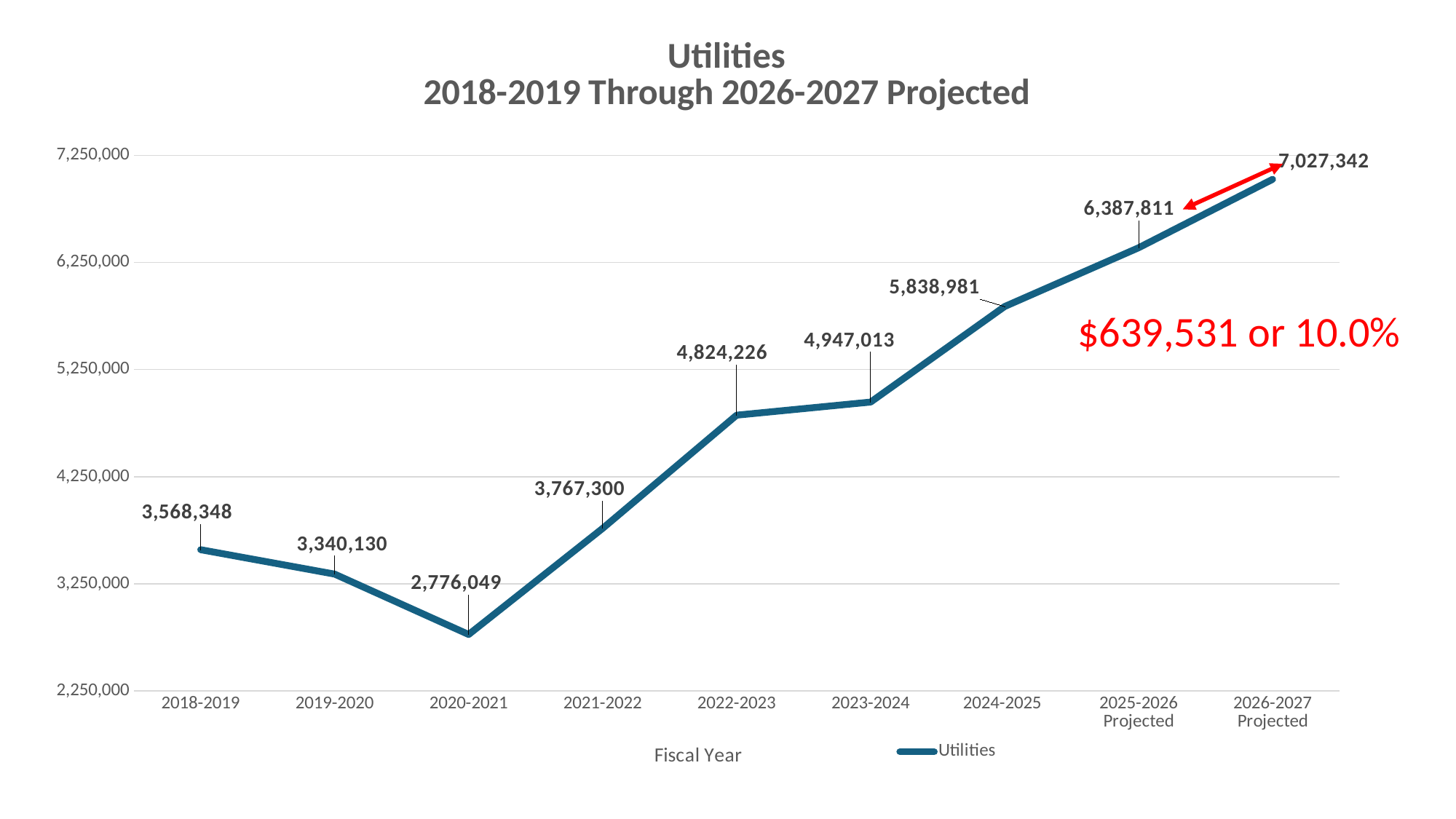
What is the projected Utilities value for 2026-2027? 7,027,342 What is the Utilities value for 2023-2024? 4,947,013 What is the difference between the 2018-2019 and 2019-2020 Utilities values? 228,218 Which fiscal year has the lowest Utilities value? 2020-2021 What kind of chart is shown on the slide? line chart What is the difference between the 2026-2027 Projected and 2025-2026 Projected Utilities values? 639,531 Which is larger, the Utilities value for 2022-2023 or for 2023-2024? 2023-2024 Is the Utilities value for 2024-2025 greater or less than 5,250,000? greater What is the title of the chart? Utilities 2018-2019 Through 2026-2027 Projected What is the Utilities value for 2020-2021? 2,776,049 Which fiscal year has the highest Utilities value? 2026-2027 Projected How many fiscal years are plotted on the chart? 9